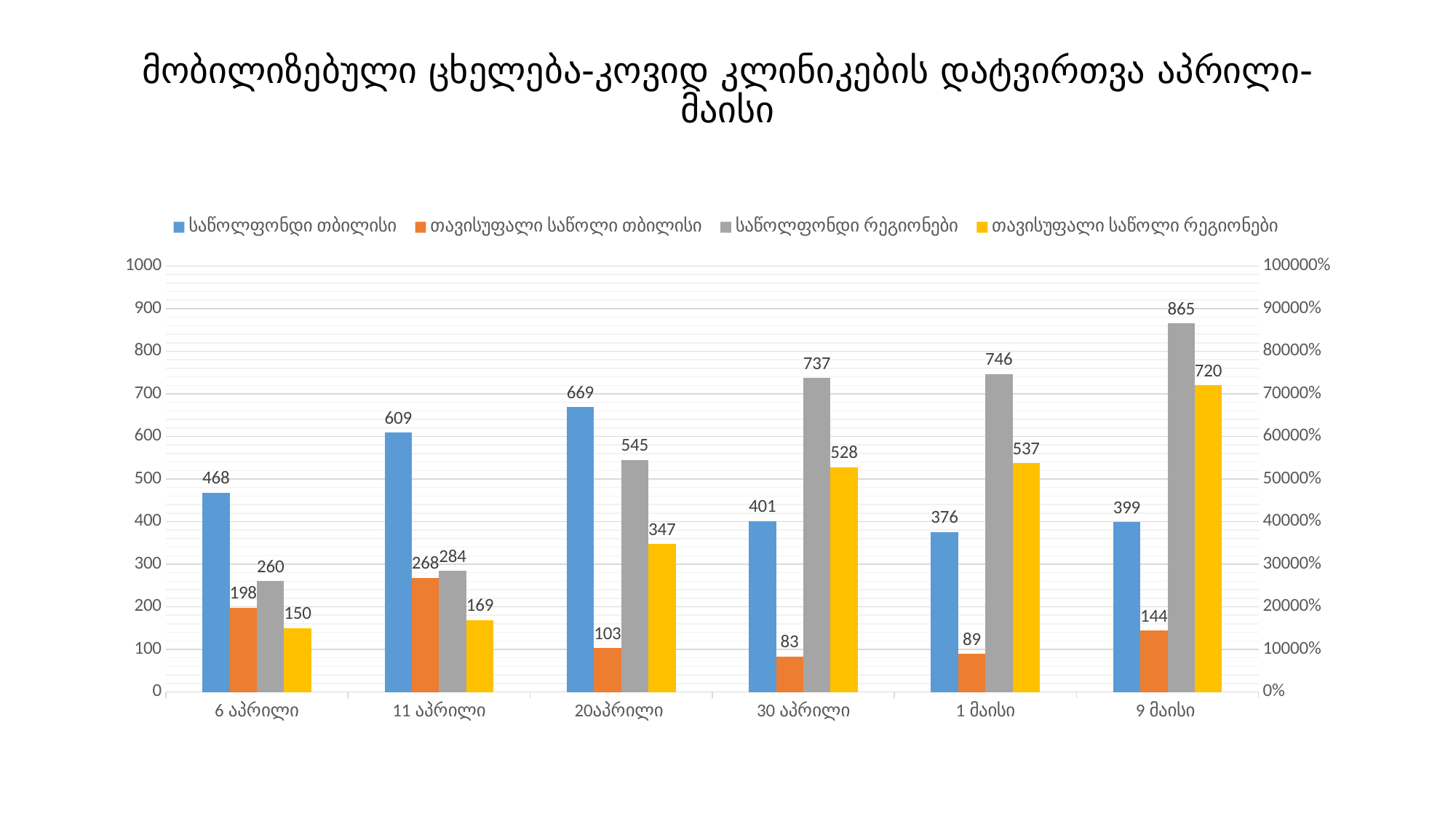
Which is larger on 11 აპრილი: საწოლფონდი თბილისი or საწოლფონდი რეგიონები? საწოლფონდი თბილისი Does საწოლფონდი რეგიონები rise or fall from 6 აპრილი to 9 მაისი? rise What kind of chart is shown on the slide? bar chart Is the value of საწოლფონდი რეგიონები on 30 აპრილი greater or less than 700? greater What is the value of თავისუფალი საწოლი თბილისი on 30 აპრილი? 83 What is the value of საწოლფონდი თბილისი on 6 აპრილი? 468 On which date is საწოლფონდი თბილისი lowest? 1 მაისი What is the value of თავისუფალი საწოლი რეგიონები on 9 მაისი? 720 On which date is საწოლფონდი რეგიონები highest? 9 მაისი How many series does the legend list? 4 What is the difference between საწოლფონდი რეგიონები and საწოლფონდი თბილისი on 9 მაისი? 466 How many dates are shown on the x axis? 6